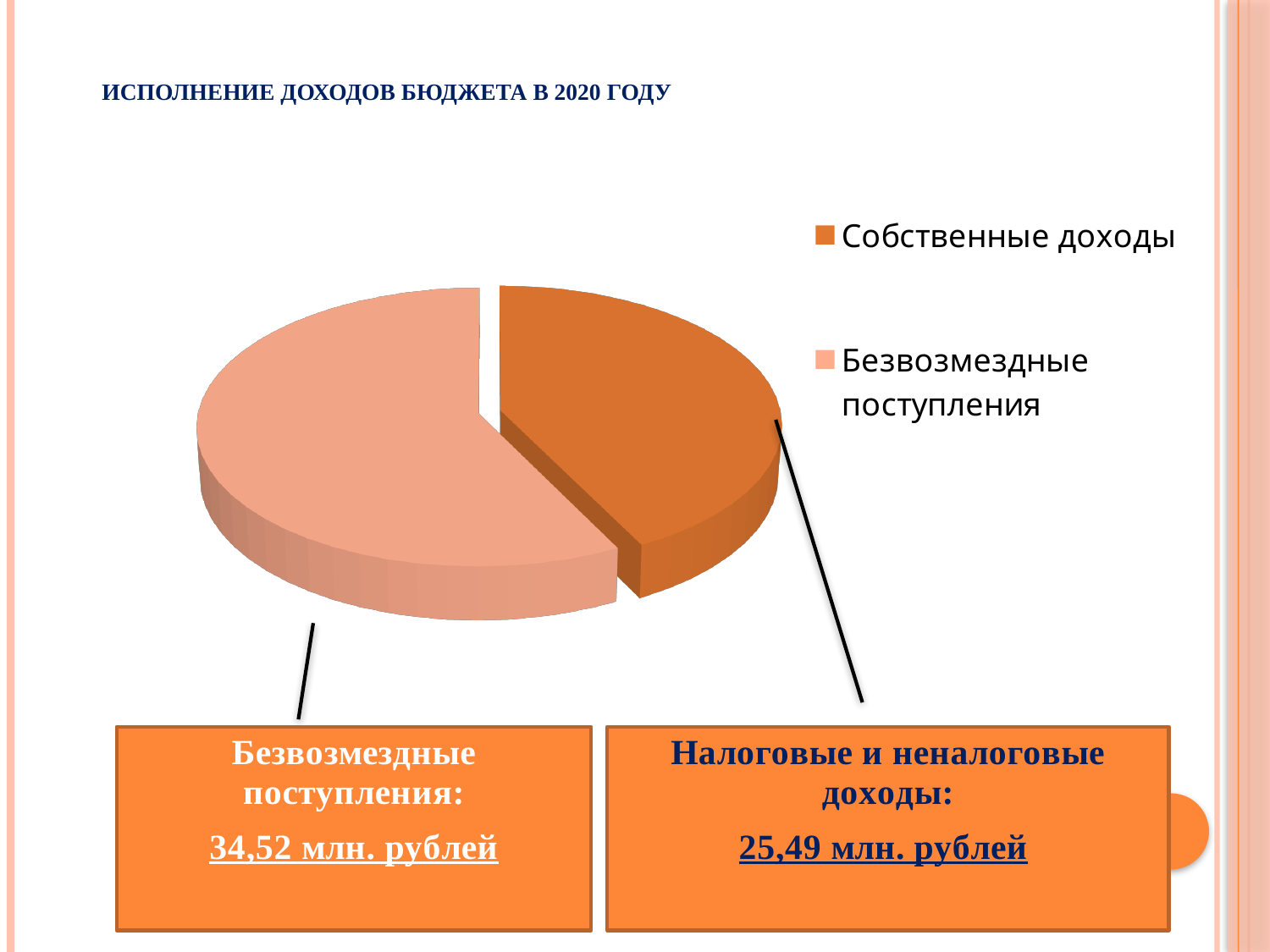
What is the total of the two values shown in the callout boxes? 60,01 млн. рублей How many entries does the legend list? 2 By how much do Безвозмездные поступления exceed Налоговые и неналоговые доходы? 9,03 млн. рублей What kind of chart is shown on the slide? pie chart Which legend entry is shown in the darker orange colour? Собственные доходы What value is given for Безвозмездные поступления? 34,52 млн. рублей How many slices does the pie chart have? 2 What is the title of the slide? ИСПОЛНЕНИЕ ДОХОДОВ БЮДЖЕТА В 2020 ГОДУ Which slice of the pie is the smallest? Собственные доходы Which is larger: Безвозмездные поступления or Налоговые и неналоговые доходы? Безвозмездные поступления Which slice of the pie is the largest? Безвозмездные поступления What value is given for Налоговые и неналоговые доходы? 25,49 млн. рублей